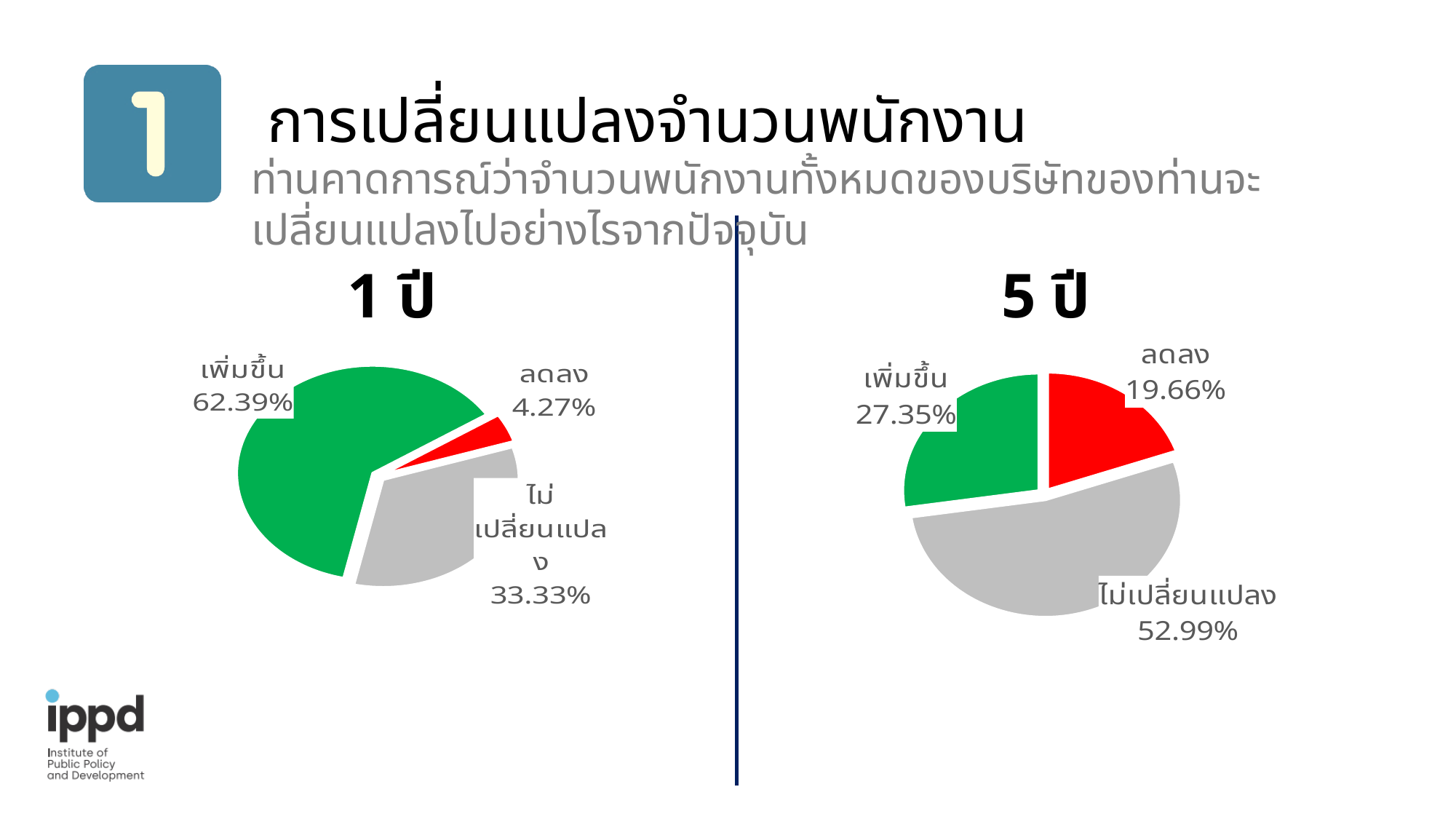
In the "5 ปี" pie chart, which is larger, เพิ่มขึ้น or ลดลง? เพิ่มขึ้น In the "5 ปี" pie chart, which category has the largest share? ไม่เปลี่ยนแปลง In the "5 ปี" pie chart, which category has the smallest share? ลดลง In the "1 ปี" pie chart, what is the difference between เพิ่มขึ้น and ไม่เปลี่ยนแปลง? 29.06% In the "1 ปี" pie chart, what is the value for เพิ่มขึ้น? 62.39% In the "1 ปี" pie chart, what is the value for ลดลง? 4.27% In the "5 ปี" pie chart, what is the value for ลดลง? 19.66% What type of chart is used for "5 ปี"? Pie chart In the "1 ปี" pie chart, which category has the largest share? เพิ่มขึ้น How many slices does the "1 ปี" pie chart have? 3 In the "5 ปี" pie chart, what colour is the ลดลง slice? Red In the "5 ปี" pie chart, what is the value for ไม่เปลี่ยนแปลง? 52.99%